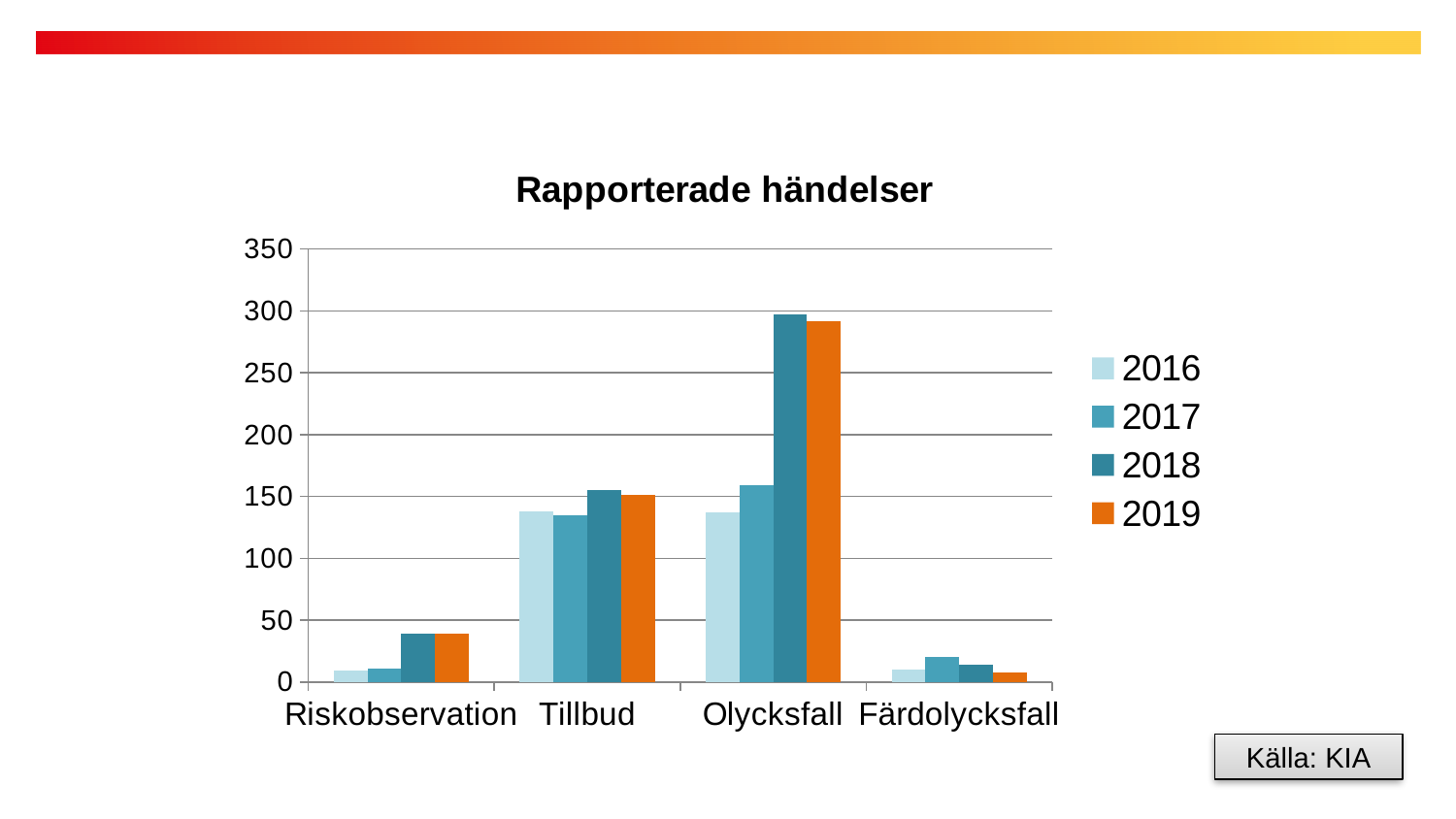
What is the title of the chart? Rapporterade händelser How many categories are shown on the x axis? 4 For Färdolycksfall, which year has the larger value: 2017 or 2019? 2017 How many series does the legend list? 4 Which is larger for 2018: Olycksfall or Tillbud? Olycksfall Is the value for Tillbud in 2016 greater or less than 100? greater For Riskobservation, which year has the larger value: 2016 or 2018? 2018 Is the value for Riskobservation in 2019 greater or less than 50? less What kind of chart is shown on the slide? bar chart Is the value for Olycksfall in 2018 greater or less than 250? greater Which category has the lowest value for 2019? Färdolycksfall Which category has the highest value for 2018? Olycksfall